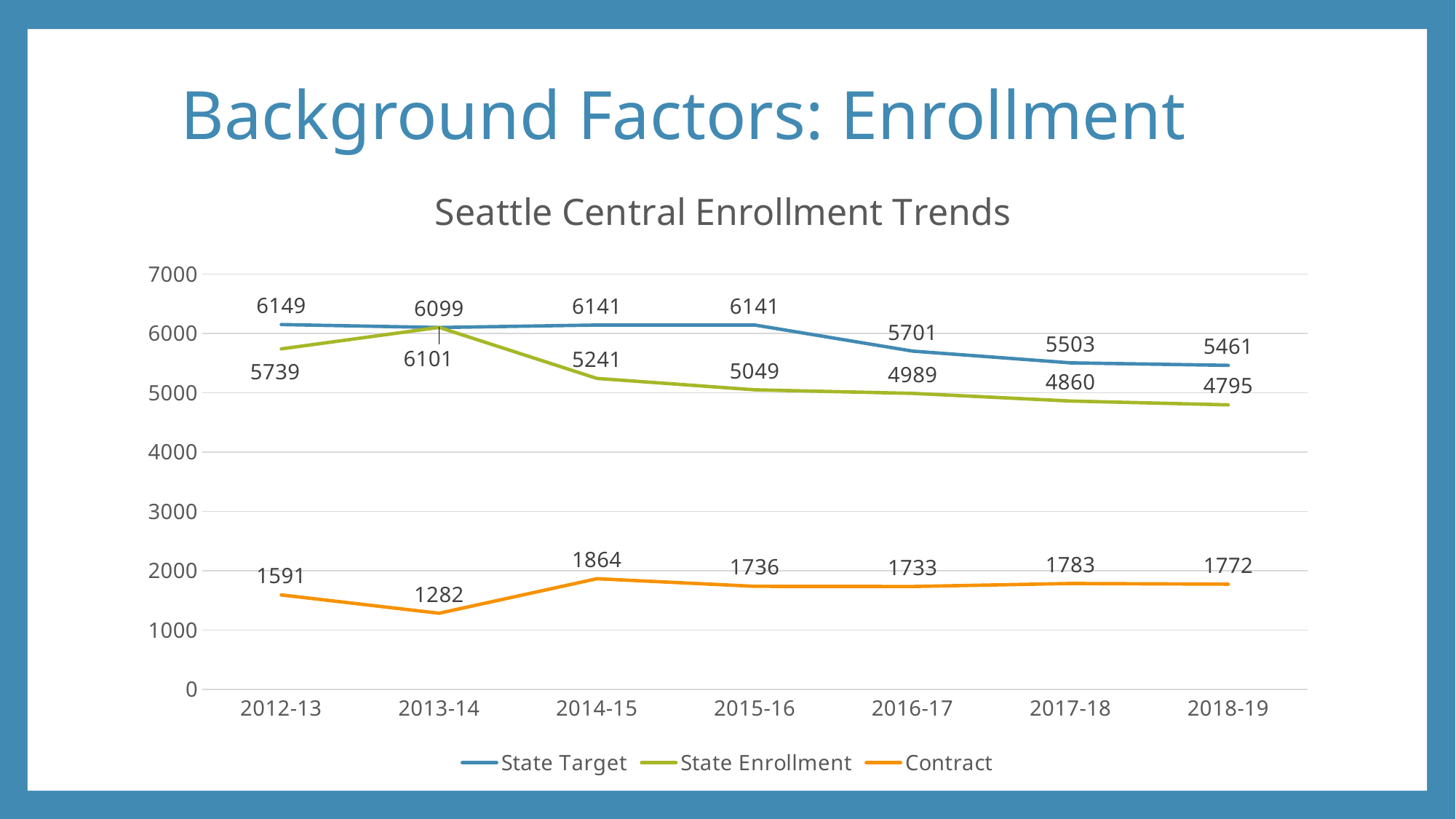
What kind of chart is shown? Line chart What is the State Enrollment value for 2018-19? 4795 What is the State Target value for 2012-13? 6149 How many series does the legend list? 3 What is the difference between the State Target and State Enrollment values in 2018-19? 666 Does the State Enrollment value rise or fall from 2014-15 to 2018-19? Fall What is the Contract value for 2014-15? 1864 Which is larger in 2013-14, State Target or State Enrollment? State Enrollment In which year is the State Enrollment value highest? 2013-14 How many years are shown on the x axis? 7 What is the title of the chart? Seattle Central Enrollment Trends In which year is the Contract value lowest? 2013-14